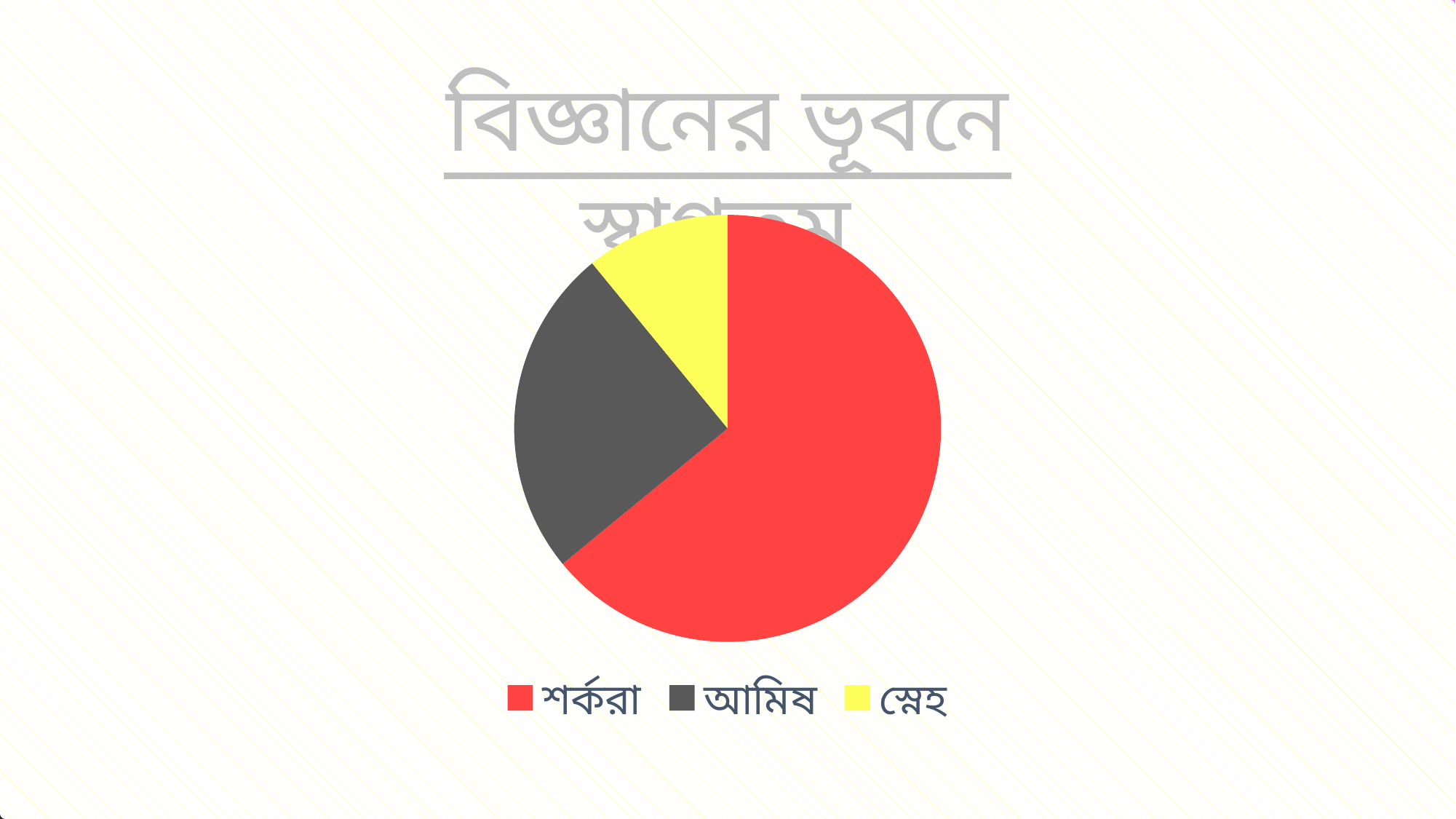
How many entries does the legend list? 3 Which category has the smallest slice of the pie? স্নেহ Which category is shown in yellow? স্নেহ Does the শর্করা slice take up more or less than half of the pie? more Which slice is larger, আমিষ or স্নেহ? আমিষ Which category has the largest slice of the pie? শর্করা How many slices does the pie chart have? 3 Which slice is larger, শর্করা or আমিষ? শর্করা What kind of chart is shown on the slide? pie chart What colour is the slice for আমিষ? dark grey